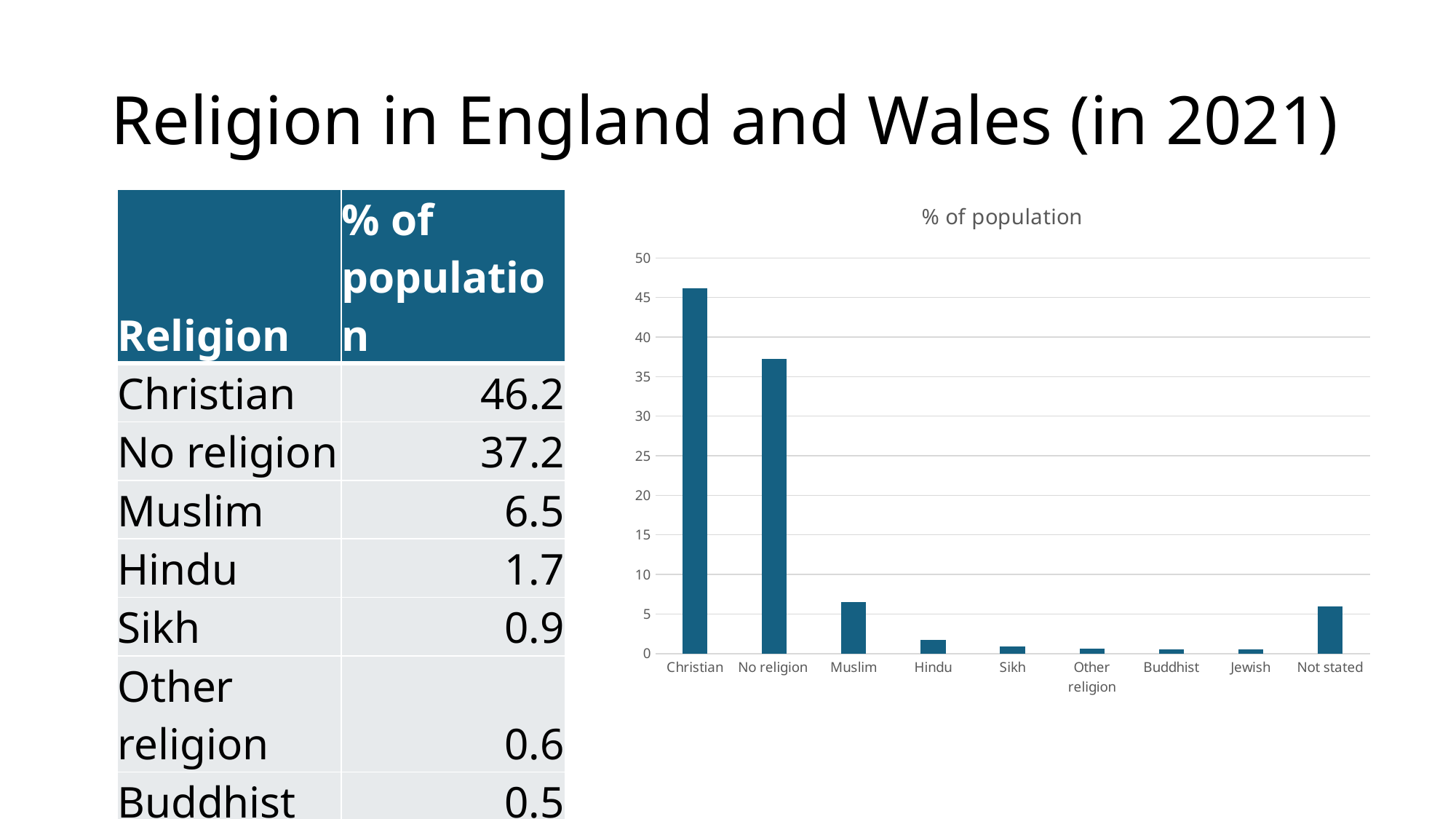
Which category has the highest value on the chart? Christian Which is larger, the value for Not stated or the value for Hindu? Not stated How many categories are plotted on the chart? 9 Is the value for Not stated greater or less than 5? greater Is the value for Jewish greater or less than 5? less What is the value for Christian? 46.2 What is the title of the chart? % of population What type of chart is shown on the slide? bar chart What is the value for Muslim? 6.5 What is the difference between the values for Christian and No religion? 9 Which is larger, the value for Muslim or the value for Hindu? Muslim What is the value for No religion? 37.2